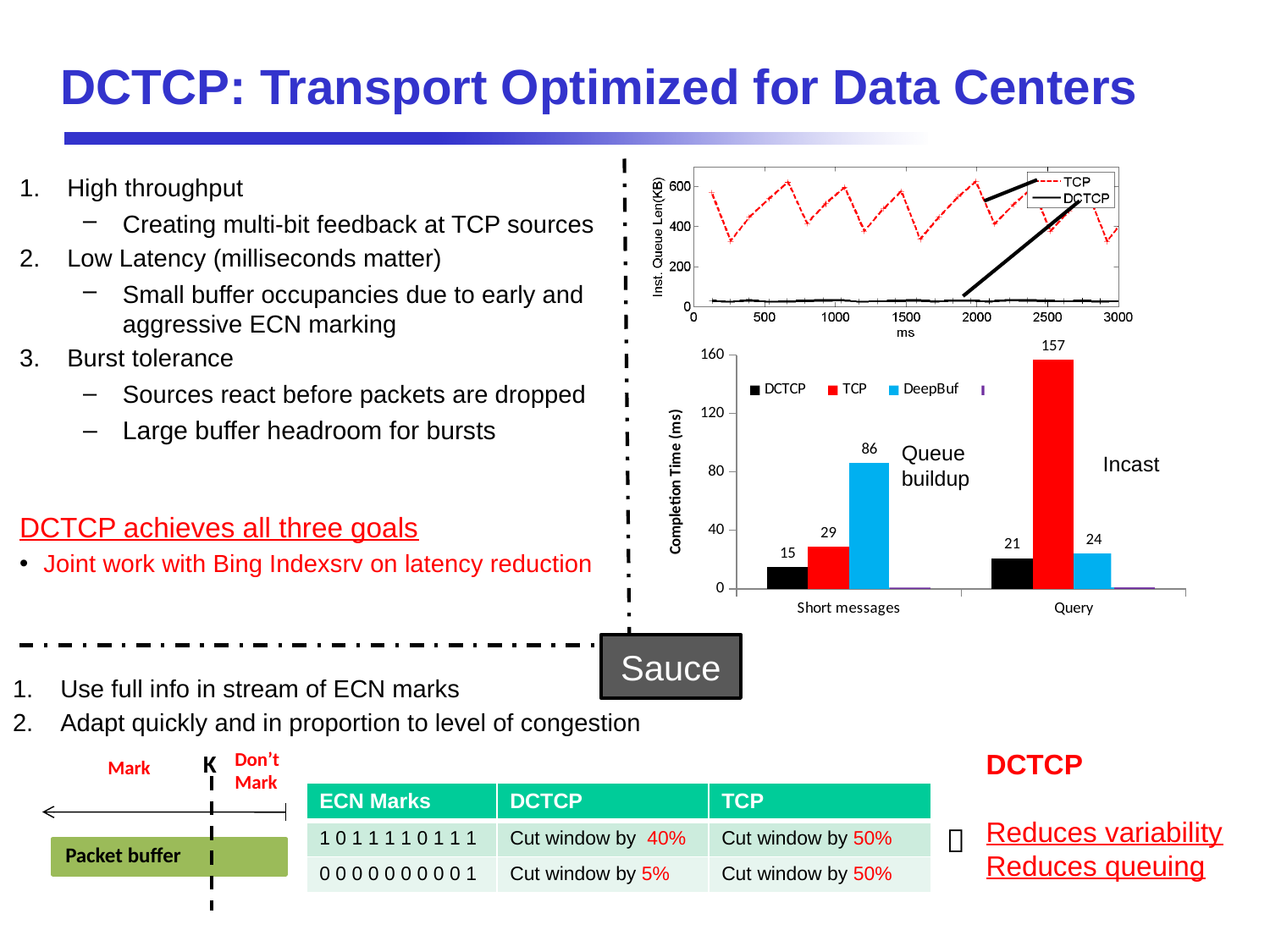
In the bar chart of completion time, which is larger: the DeepBuf value for Query or the TCP value for Short messages? TCP value for Short messages In the bar chart of completion time, how many categories are shown on the x axis? 2 In the bar chart of completion time, what is the completion time for DeepBuf for Short messages? 86 In the bar chart of completion time, what is the completion time for TCP for Query? 157 In the bar chart of completion time, what is the completion time for DCTCP for Short messages? 15 In the bar chart of completion time, what is the completion time for DeepBuf for Query? 24 In the line chart of instantaneous queue length, how many series does the legend list? 2 In the bar chart of completion time, what is the difference between the DeepBuf and TCP values for Short messages? 57 In the line chart of instantaneous queue length, is the DCTCP queue length at 1500 ms greater or less than 200? less In the bar chart of completion time, which series has the highest value for Query? TCP In the bar chart of completion time, what is the difference between the TCP and DCTCP values for Query? 136